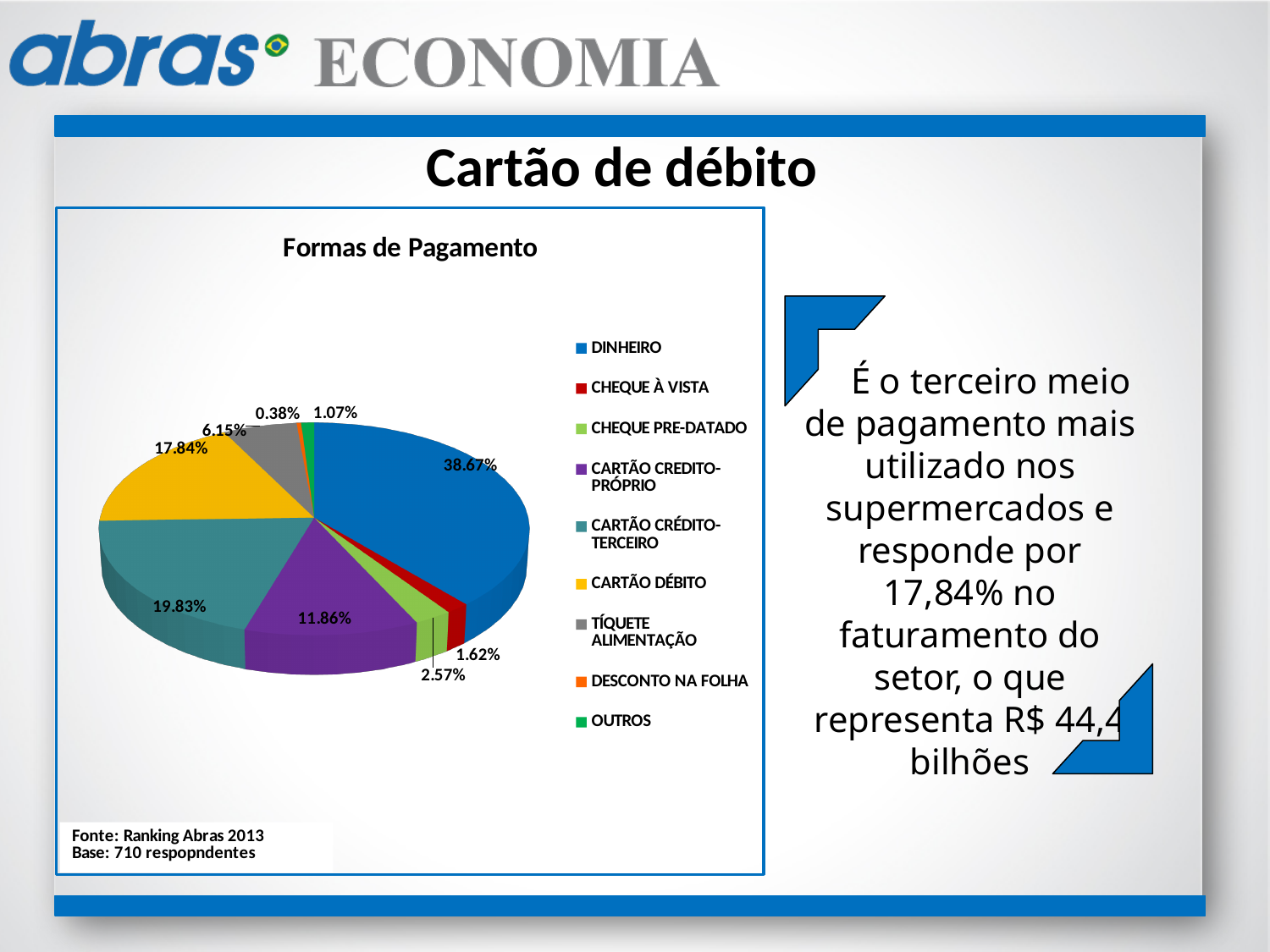
What is the value for TÍQUETE ALIMENTAÇÃO? 6.15% What is the value for CARTÃO DÉBITO? 17.84% What is the value for CARTÃO CRÉDITO-TERCEIRO? 19.83% What type of chart is shown on the slide? pie chart What share of the pie does DINHEIRO represent? 38.67% Which payment method has the smallest slice of the pie? DESCONTO NA FOLHA What is the difference between the shares of CARTÃO CRÉDITO-TERCEIRO and CARTÃO DÉBITO? 1.99% What is the title of the chart? Formas de Pagamento Which is larger, the share for CARTÃO CREDITO-PRÓPRIO or the share for TÍQUETE ALIMENTAÇÃO? CARTÃO CREDITO-PRÓPRIO What is the value for CHEQUE PRE-DATADO? 2.57% How many series does the legend list? 9 Which payment method has the largest slice of the pie? DINHEIRO